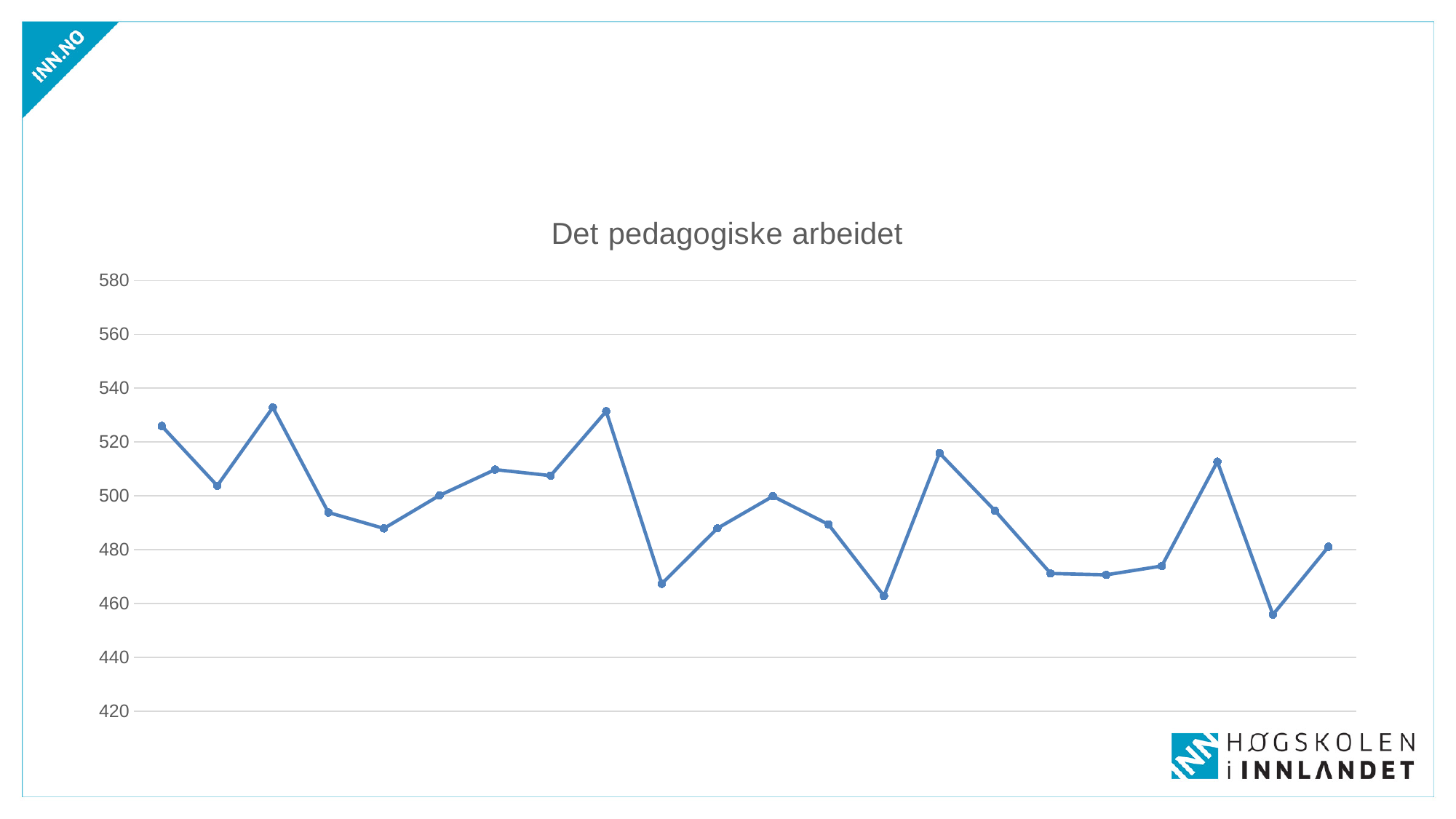
Which is larger, the value of the first point or the value of the last point? the first point What is the title of the chart? Det pedagogiske arbeidet What kind of chart is shown on the slide? line chart Is the value of the point immediately after the third point greater or less than 500? less Is the value of the first (leftmost) point greater or less than 520? greater Overall, do the values rise or fall from left to right along the x axis? fall Is the value of the last (rightmost) point greater or less than 500? less How many data points are plotted on the line? 22 What is the highest value shown on the y axis? 580